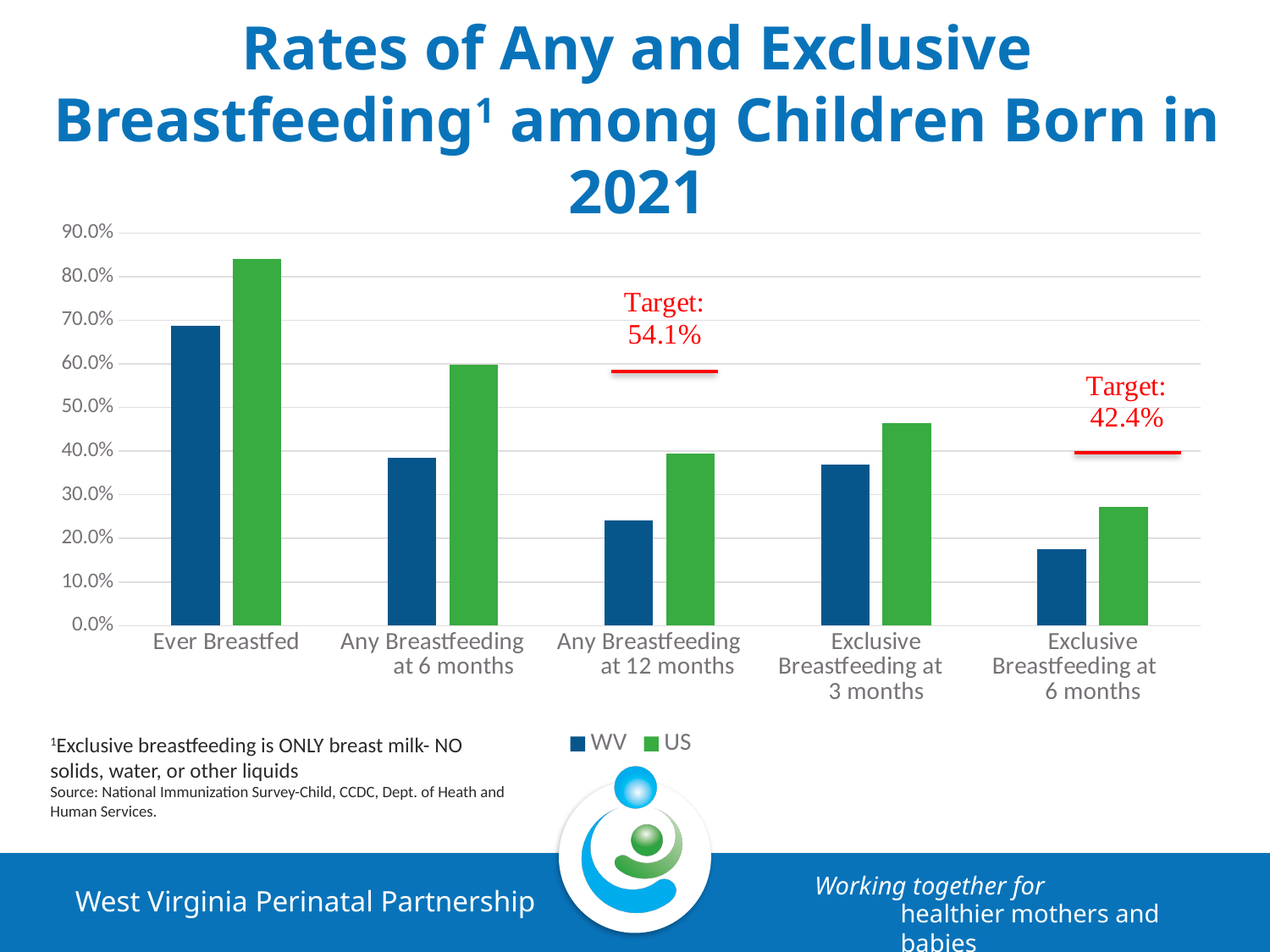
Is the WV value for Ever Breastfed greater or less than 60.0%? greater How many series does the legend list? 2 Is the US value for Any Breastfeeding at 6 months greater or less than 50.0%? greater Which is larger, the US value for Exclusive Breastfeeding at 3 months or the US value for Any Breastfeeding at 12 months? Exclusive Breastfeeding at 3 months What target is annotated above the Exclusive Breastfeeding at 6 months bars? 42.4% Is the WV value for Any Breastfeeding at 12 months greater or less than 30.0%? less For Ever Breastfed, which is larger, the WV value or the US value? US Which category has the highest US value? Ever Breastfed What kind of chart is shown on the slide? Bar chart Which category has the lowest WV value? Exclusive Breastfeeding at 6 months What target is annotated above the Any Breastfeeding at 12 months bars? 54.1% How many breastfeeding categories are shown along the x axis? 5